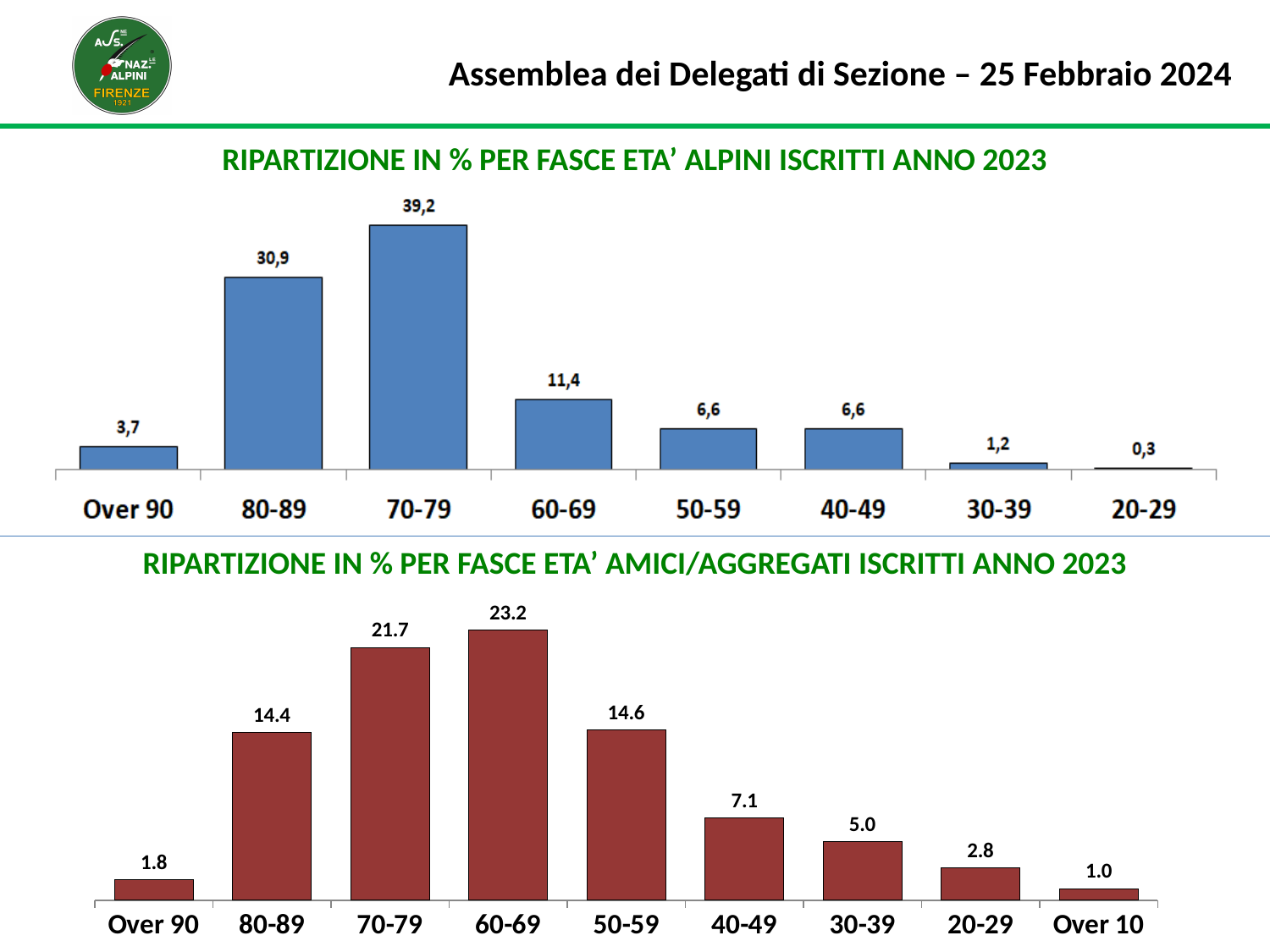
In the bottom chart (AMICI/AGGREGATI ISCRITTI ANNO 2023), how many age groups are shown? 9 What type of chart is the bottom chart (AMICI/AGGREGATI ISCRITTI ANNO 2023)? Bar chart In the bottom chart (AMICI/AGGREGATI ISCRITTI ANNO 2023), which age group has the lowest value? Over 10 What colour are the bars in the top chart (ALPINI ISCRITTI ANNO 2023)? Blue In the top chart (ALPINI ISCRITTI ANNO 2023), which age group has the highest value? 70-79 In the bottom chart (AMICI/AGGREGATI ISCRITTI ANNO 2023), which age group has the highest value? 60-69 In the top chart (ALPINI ISCRITTI ANNO 2023), what is the value for the 70-79 age group? 39,2 In the top chart (ALPINI ISCRITTI ANNO 2023), how many age groups are shown? 8 In the bottom chart (AMICI/AGGREGATI ISCRITTI ANNO 2023), what is the value for the 50-59 age group? 14.6 In the bottom chart (AMICI/AGGREGATI ISCRITTI ANNO 2023), which is larger, the value for 80-89 or the value for 40-49? 80-89 In the top chart (ALPINI ISCRITTI ANNO 2023), what is the difference between the values for 80-89 and 60-69? 19,5 In the top chart (ALPINI ISCRITTI ANNO 2023), which age group has the lowest value? 20-29